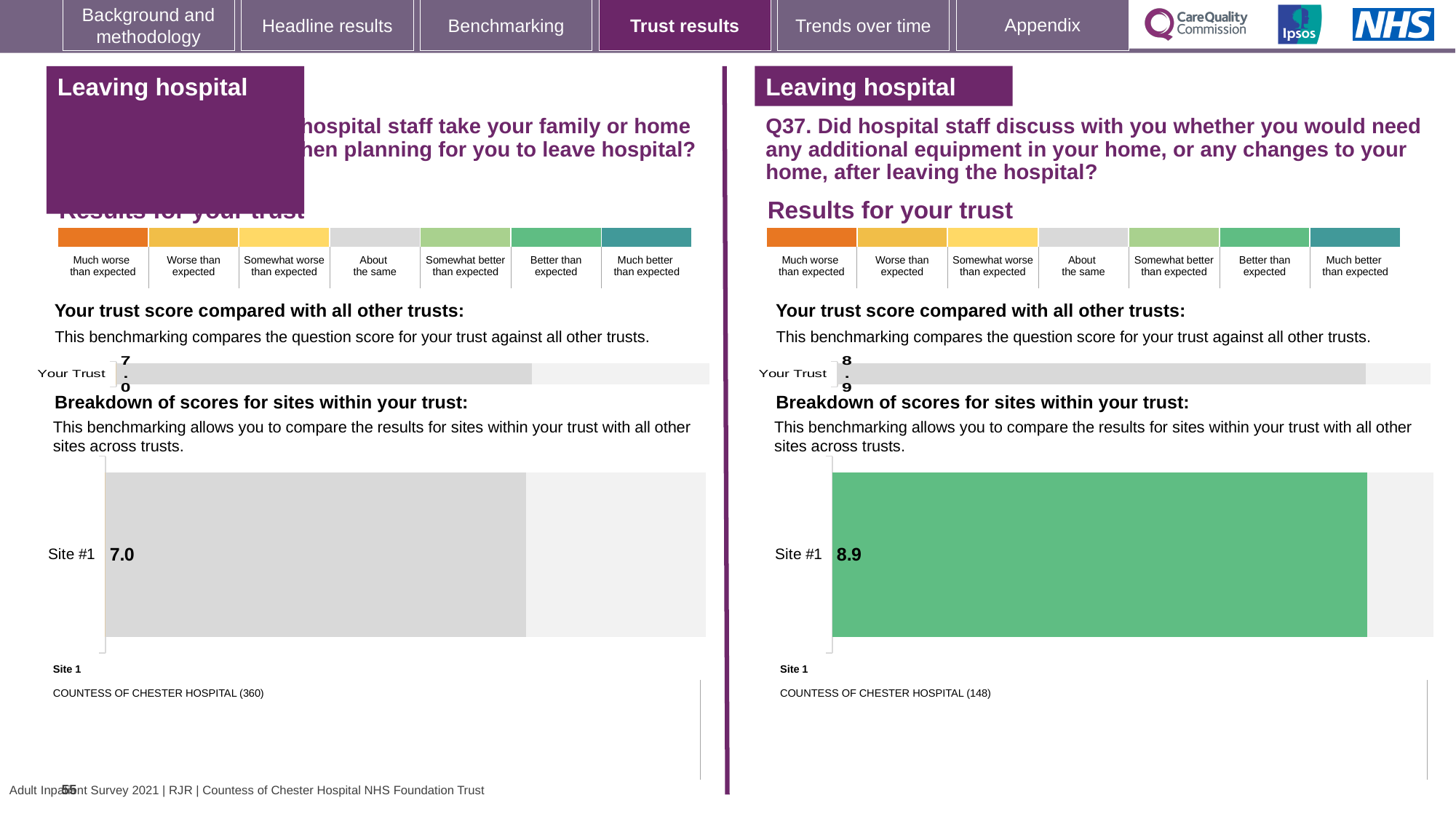
How many sites are shown in the site breakdown chart on the left-hand side of the slide? 1 What colour is the Site #1 bar on the left-hand chart? Grey On the right-hand side of the slide (Q37), what is the 'Your Trust' score shown in the trust comparison bar? 8.9 On the right-hand chart (Q37), what is the score shown for Site #1? 8.9 How many sites are shown in the site breakdown chart on the right-hand side (Q37)? 1 On the left-hand chart, what is the score shown for Site #1? 7.0 What colour is the Site #1 bar on the right-hand chart (Q37)? Green What is the difference between the Site #1 score on the right-hand chart (Q37) and the Site #1 score on the left-hand chart? 1.9 Which hospital is listed as Site 1 beneath the right-hand chart (Q37)? COUNTESS OF CHESTER HOSPITAL (148) What type of chart is used to show the breakdown of scores for sites within the trust on the right-hand side (Q37)? Bar chart On the left-hand side of the slide, what is the 'Your Trust' score shown in the trust comparison bar? 7.0 Which Site #1 score is larger: the one on the left-hand chart or the one on the right-hand chart (Q37)? The right-hand chart (Q37)